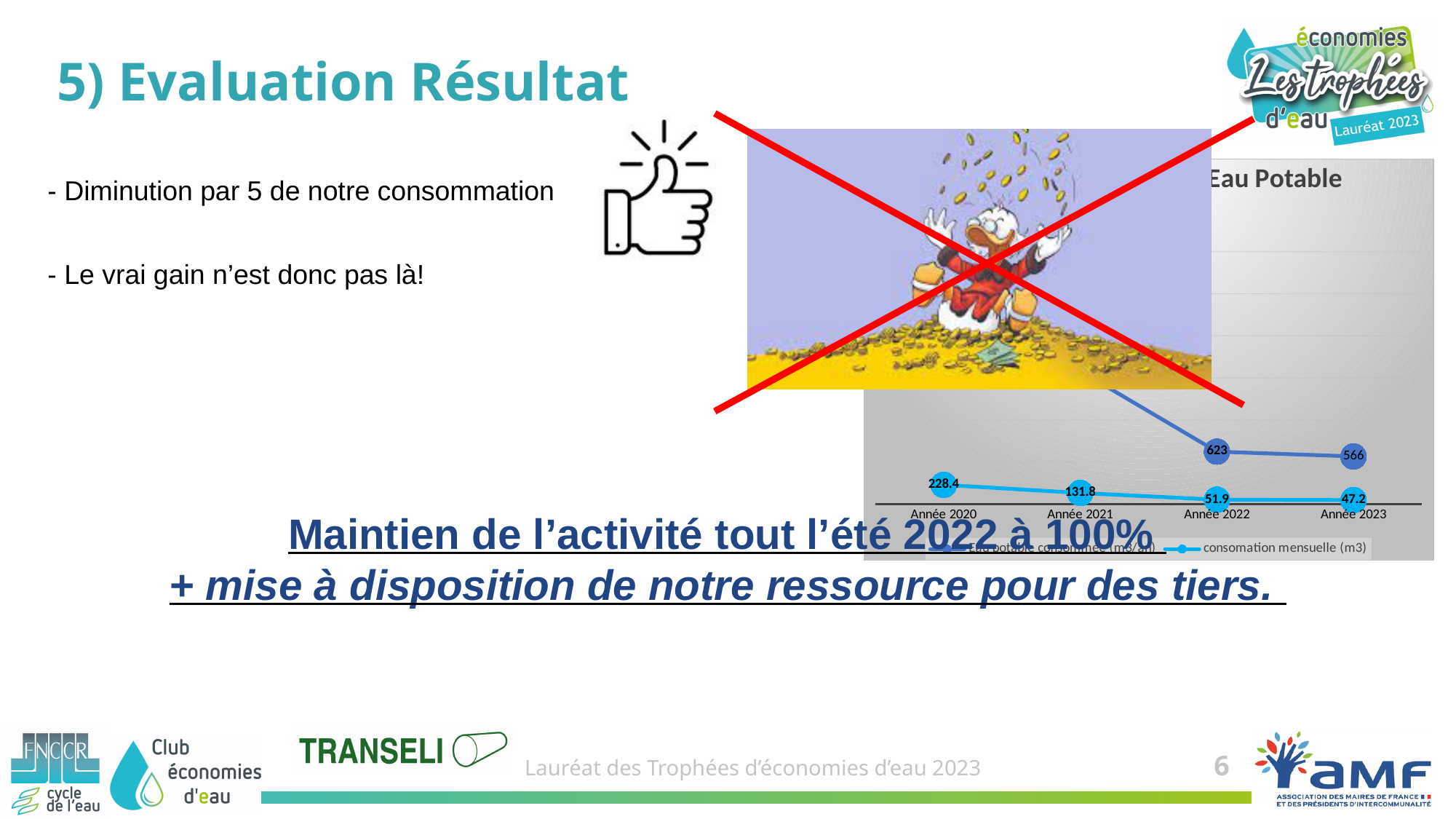
What is the value of the 'consomation mensuelle (m3)' series for Année 2022? 51.9 What is the value of the 'consomation mensuelle (m3)' series for Année 2023? 47.2 By how much did the dark blue series decrease from Année 2022 to Année 2023? 57 What is the difference between the 'consomation mensuelle (m3)' values for Année 2020 and Année 2021? 96.6 What is the value of the 'consomation mensuelle (m3)' series for Année 2021? 131.8 How many years are shown on the x axis of the chart? 4 What kind of chart is shown on the slide? line chart What is the value of the 'consomation mensuelle (m3)' series for Année 2020? 228.4 What is the value of the dark blue series for Année 2022? 623 What is the value of the dark blue series for Année 2023? 566 Which year has the lowest value for the 'consomation mensuelle (m3)' series? Année 2023 Does the 'consomation mensuelle (m3)' series rise or fall from Année 2020 to Année 2023? fall